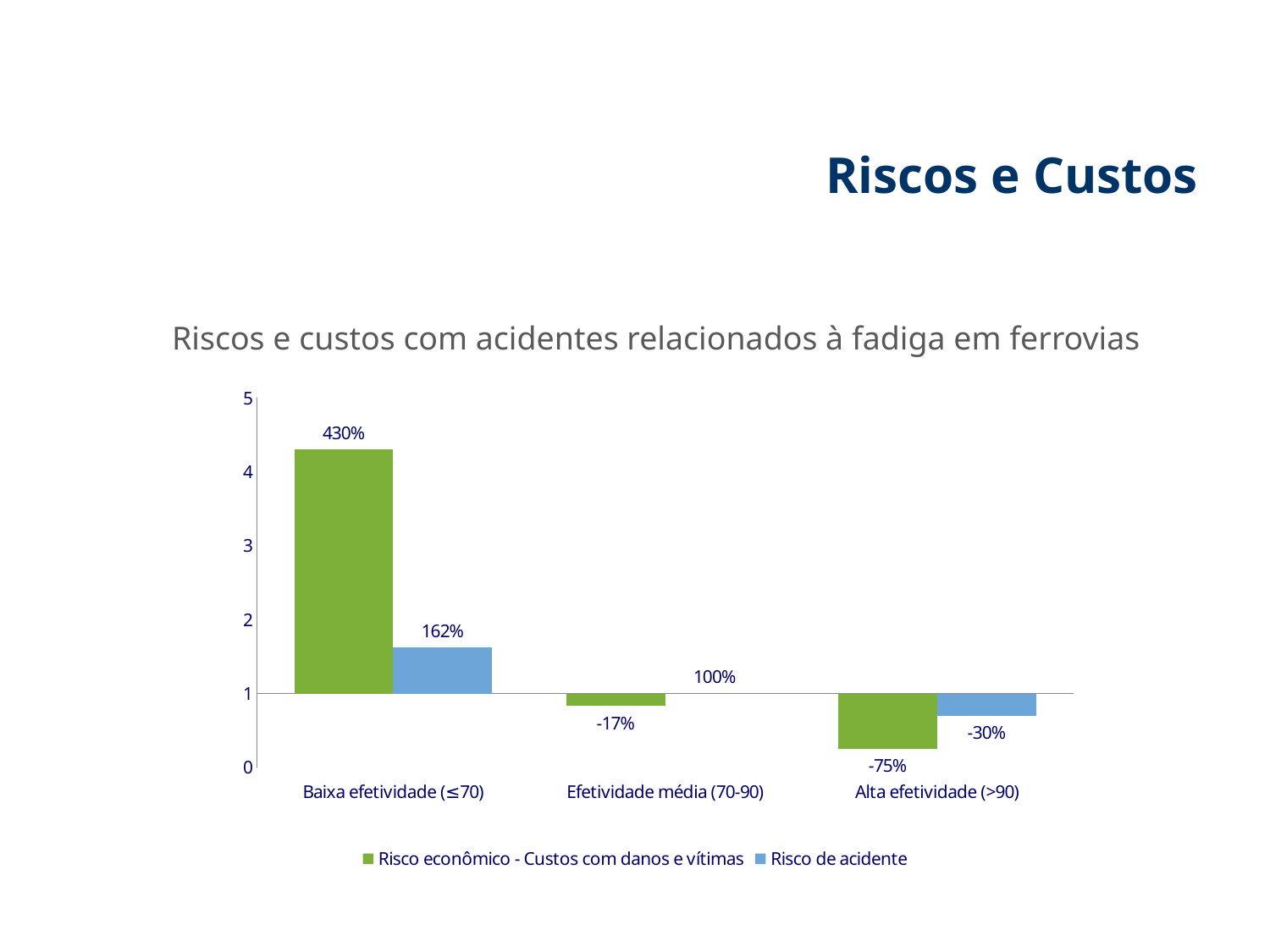
What is the value for Risco de acidente at Alta efetividade (>90)? -30% At Baixa efetividade (≤70), which series has the larger value: Risco econômico - Custos com danos e vítimas or Risco de acidente? Risco econômico - Custos com danos e vítimas Which category has the highest value for Risco econômico - Custos com danos e vítimas? Baixa efetividade (≤70) How many categories are shown on the x axis? 3 What is the value for Risco econômico - Custos com danos e vítimas at Alta efetividade (>90)? -75% What is the value for Risco econômico - Custos com danos e vítimas at Baixa efetividade (≤70)? 430% Which category has the lowest value for Risco econômico - Custos com danos e vítimas? Alta efetividade (>90) What is the value for Risco econômico - Custos com danos e vítimas at Efetividade média (70-90)? -17% What is the value for Risco de acidente at Baixa efetividade (≤70)? 162% How many series does the legend list? 2 What kind of chart is shown on the slide? Bar chart What is the value for Risco de acidente at Efetividade média (70-90)? 100%